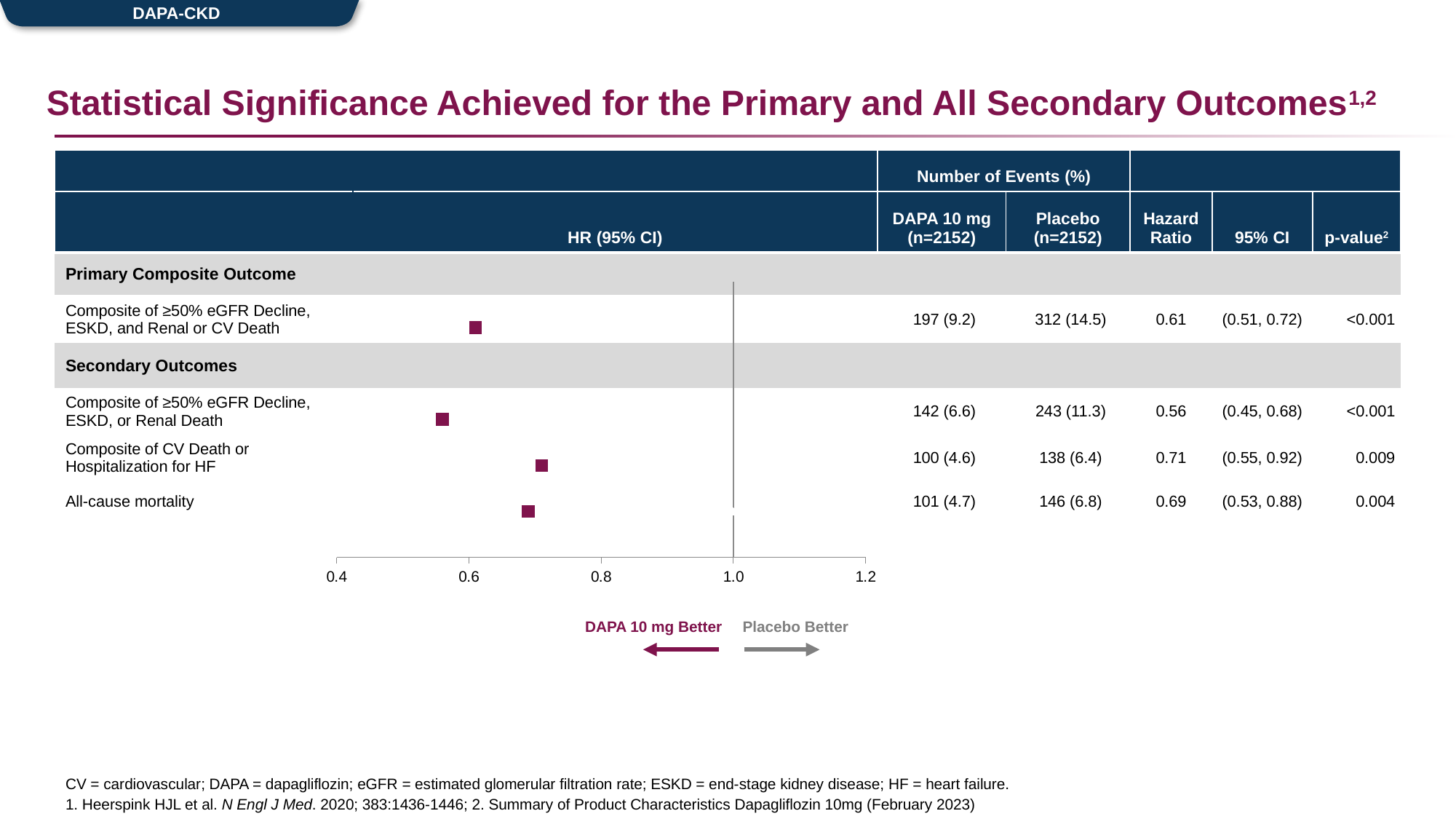
Which outcome has the lowest hazard ratio on the plot? Composite of ≥50% eGFR Decline, ESKD, or Renal Death According to the arrows below the x axis, which direction indicates 'DAPA 10 mg Better'? Left (toward lower hazard ratios) What is the difference between the highest and lowest hazard ratios plotted? 0.15 Is the hazard ratio for the Composite of ≥50% eGFR Decline, ESKD, or Renal Death greater or less than 0.6? less What is the hazard ratio plotted for the Composite of ≥50% eGFR Decline, ESKD, and Renal or CV Death? 0.61 Is the hazard ratio for All-cause mortality greater or less than 1.0? less What kind of chart is shown on the slide? Forest plot What is the hazard ratio plotted for the Composite of CV Death or Hospitalization for HF? 0.71 How many outcomes are plotted as points on the chart? 4 Which outcome has the highest hazard ratio on the plot? Composite of CV Death or Hospitalization for HF What is the hazard ratio plotted for the Composite of ≥50% eGFR Decline, ESKD, or Renal Death? 0.56 What is the hazard ratio plotted for All-cause mortality? 0.69